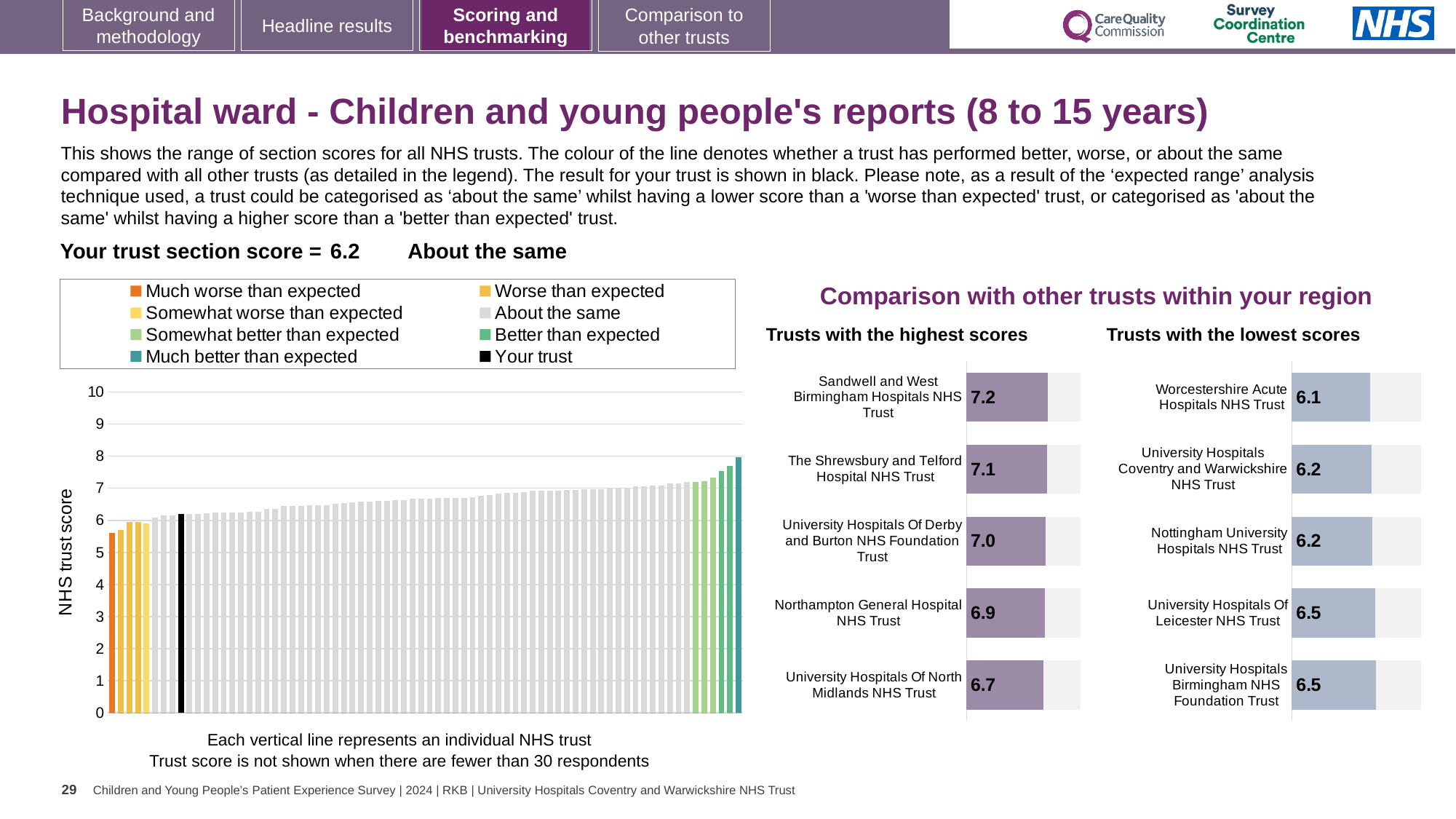
In the 'Trusts with the lowest scores' chart, which is larger: the score for University Hospitals Of Leicester NHS Trust or Nottingham University Hospitals NHS Trust? University Hospitals Of Leicester NHS Trust In the 'Trusts with the lowest scores' chart, what is the difference between the scores of University Hospitals Birmingham NHS Foundation Trust and Worcestershire Acute Hospitals NHS Trust? 0.4 In the large chart on the left, is the value of the tallest bar greater or less than 7? greater In the large chart on the left, do the trust scores rise or fall from left to right? Rise In the 'Trusts with the lowest scores' chart, what is the score for Worcestershire Acute Hospitals NHS Trust? 6.1 In the 'Trusts with the lowest scores' chart, which trust has the lowest score? Worcestershire Acute Hospitals NHS Trust In the 'Trusts with the highest scores' chart, how many trusts are shown? 5 In the 'Trusts with the highest scores' chart, what is the score for Sandwell and West Birmingham Hospitals NHS Trust? 7.2 In the 'Trusts with the highest scores' chart, what is the difference between the scores of Sandwell and West Birmingham Hospitals NHS Trust and University Hospitals Of North Midlands NHS Trust? 0.5 In the 'Trusts with the highest scores' chart, which trust has the lowest score? University Hospitals Of North Midlands NHS Trust What type of chart is the large chart on the left showing NHS trust scores? Bar chart How many entries does the legend above the large chart on the left list? 8